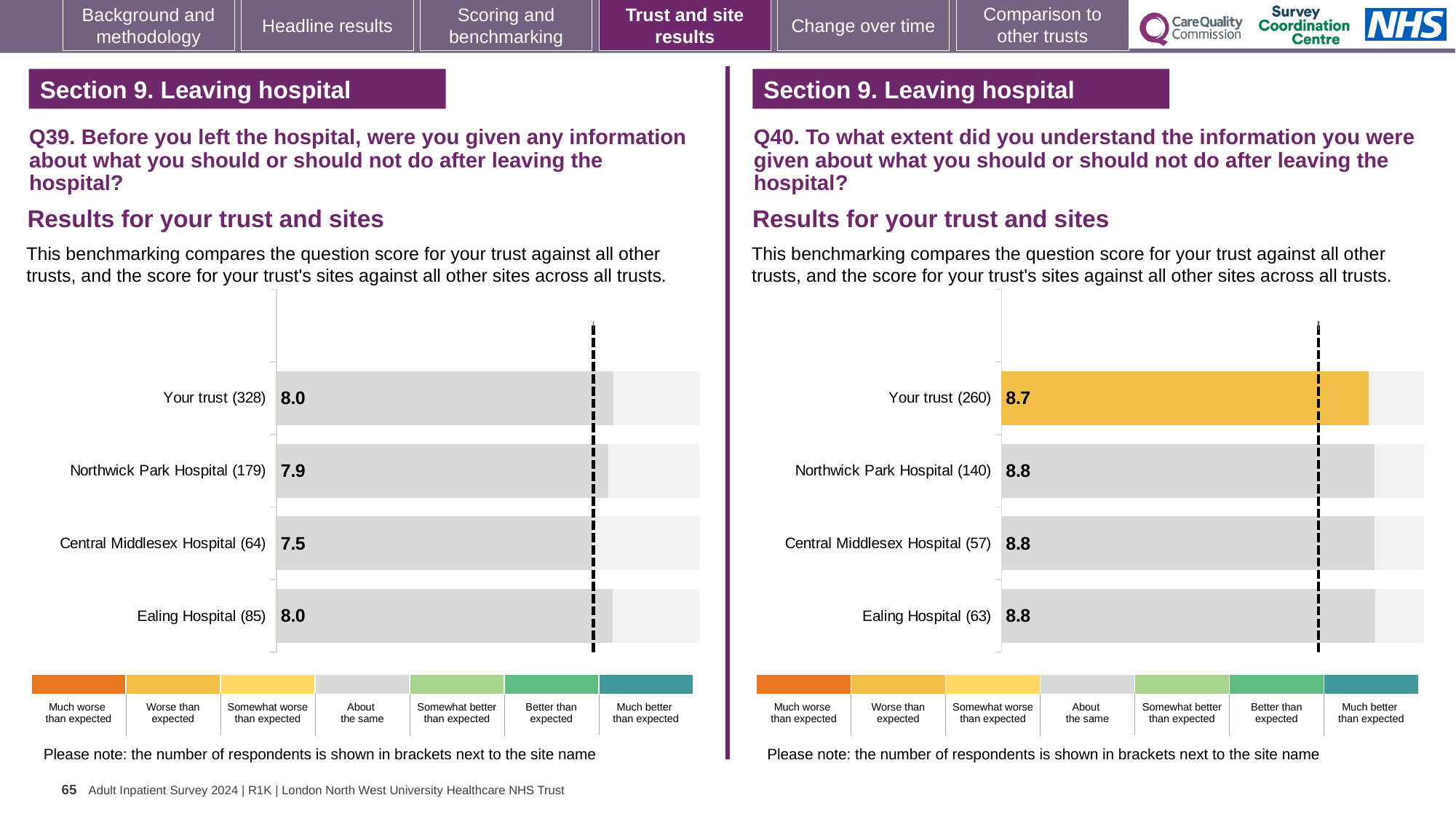
What type of chart is used for the Q40 results on the right? bar chart In the Q40 chart on the right, what is the score for Ealing Hospital? 8.8 In the Q39 chart on the left, which site has the lowest score? Central Middlesex Hospital In the Q40 chart on the right, is the score for Northwick Park Hospital larger or smaller than the score for Your trust? larger In the Q39 chart on the left, what is the difference between the scores for Ealing Hospital and Central Middlesex Hospital? 0.5 In the Q40 chart on the right, what is the score for Your trust? 8.7 In the Q40 chart on the right, which bar is coloured yellow rather than grey? Your trust How many bars are plotted in the Q39 chart on the left? 4 In the Q39 chart on the left, how many respondents are shown in brackets for Northwick Park Hospital? 179 In the Q39 chart on the left, what is the score for Your trust? 8.0 In the Q40 chart on the right, which row has the lowest score? Your trust In the Q39 chart on the left, what is the score for Central Middlesex Hospital? 7.5